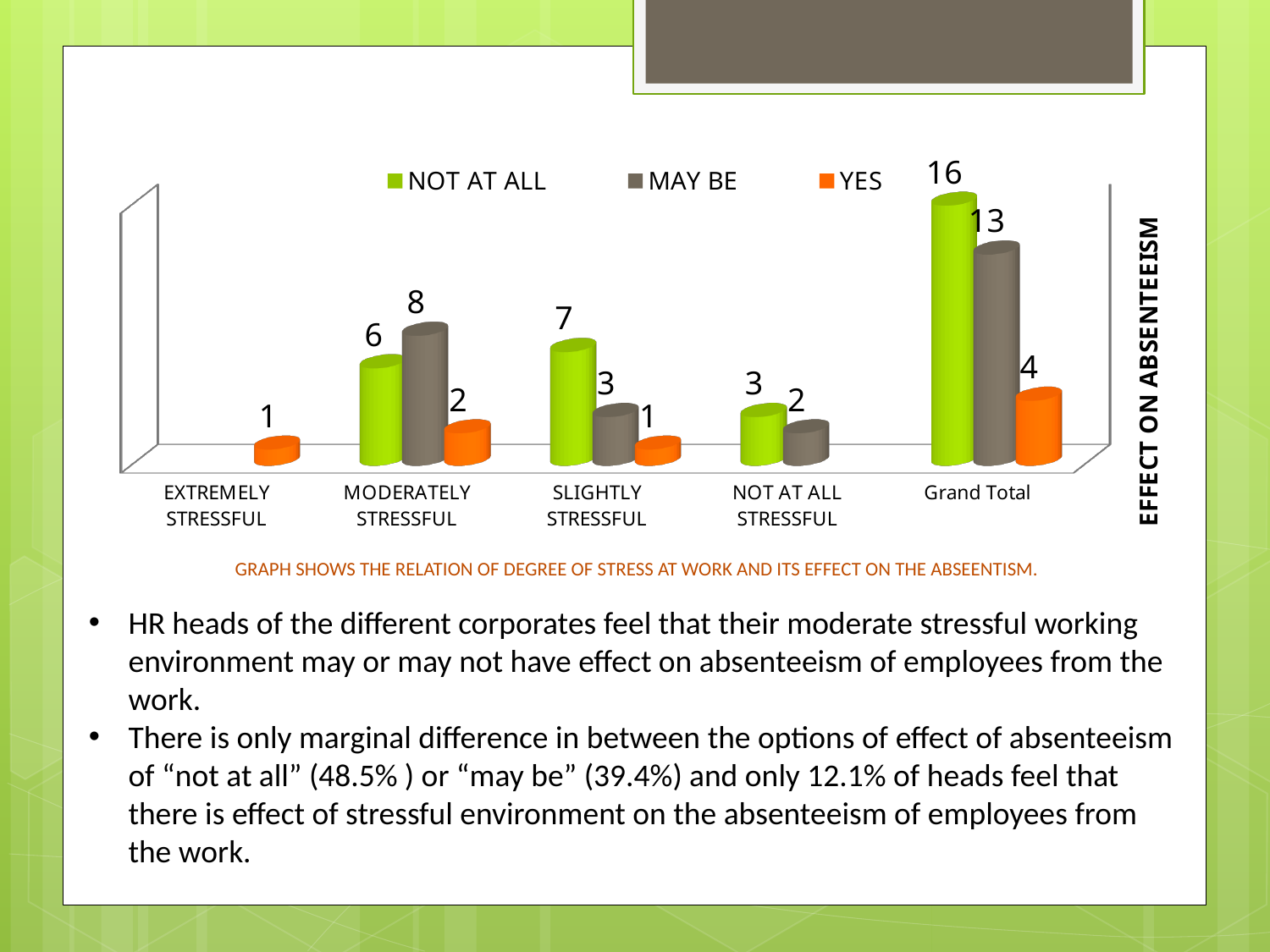
What is the value of YES for EXTREMELY STRESSFUL? 1 Which is larger for SLIGHTLY STRESSFUL: NOT AT ALL or MAY BE? NOT AT ALL What is the value of NOT AT ALL for SLIGHTLY STRESSFUL? 7 What kind of chart is shown on the slide? Bar chart How many categories are shown on the x axis? 5 Which series has the highest value in the Grand Total category? NOT AT ALL What is the title of the vertical axis? EFFECT ON ABSENTEEISM How many series does the legend list? 3 Which series has the lowest value in the MODERATELY STRESSFUL category? YES What is the value of MAY BE for MODERATELY STRESSFUL? 8 What is the value of YES for Grand Total? 4 What is the difference between the NOT AT ALL and MAY BE values for Grand Total? 3